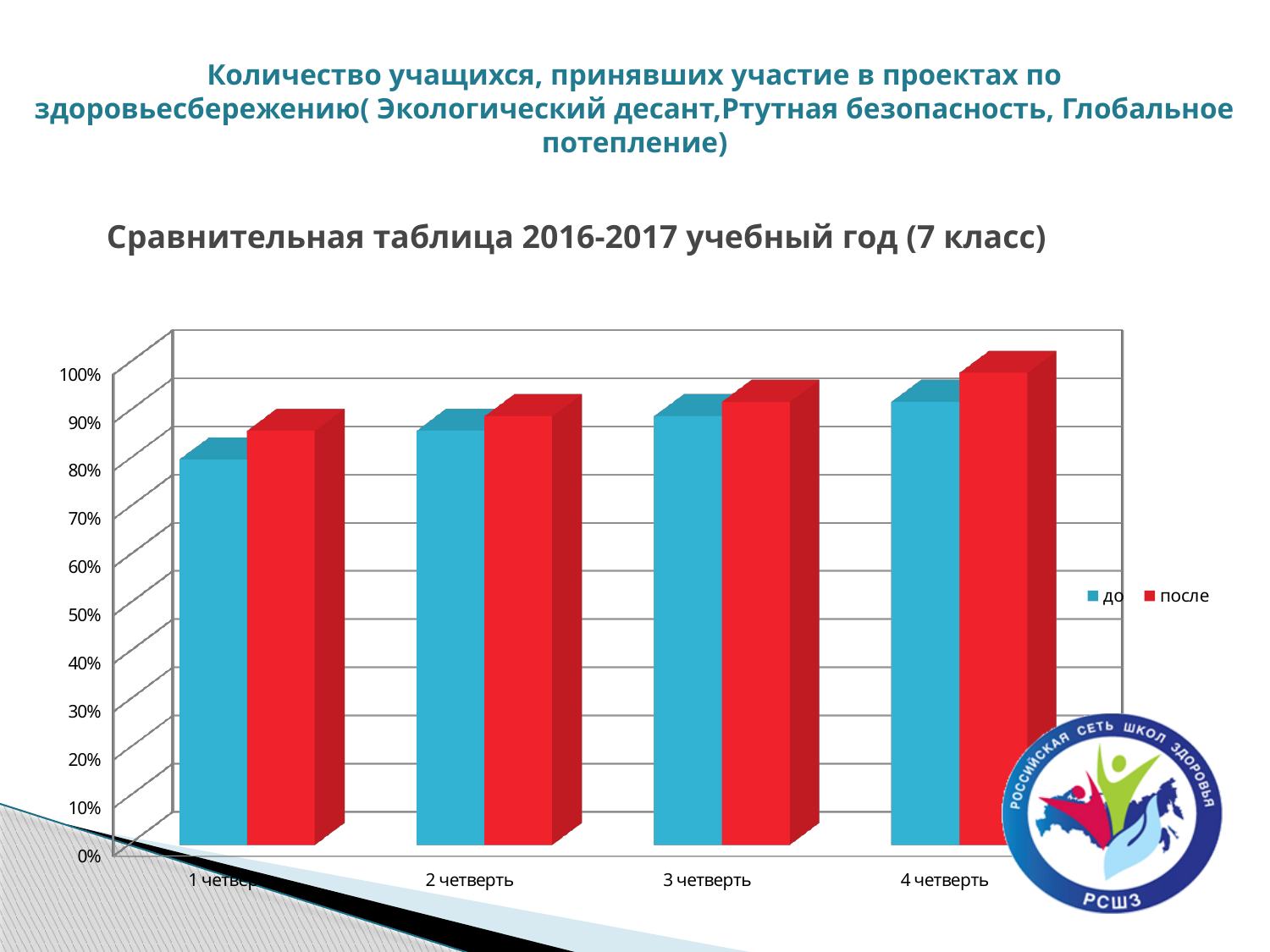
Which quarter has the lowest value for the 'до' series? 1 четверть How many series does the legend list? 2 Which quarter has the highest value for the 'после' series? 4 четверть Is the value for 'после' in 1 четверть greater or less than 80%? greater What school year and class does the chart subtitle say the comparison covers? 2016-2017 учебный год (7 класс) What kind of chart is shown on the slide? bar chart Is the value for 'до' in 1 четверть greater or less than 90%? less In 1 четверть, which is larger: 'до' or 'после'? после How many categories (quarters) are shown on the x axis? 4 Is the value for 'после' in 4 четверть greater or less than 90%? greater What are the two series named in the legend? до, после Do the values for the 'до' series rise or fall from 1 четверть to 4 четверть? rise